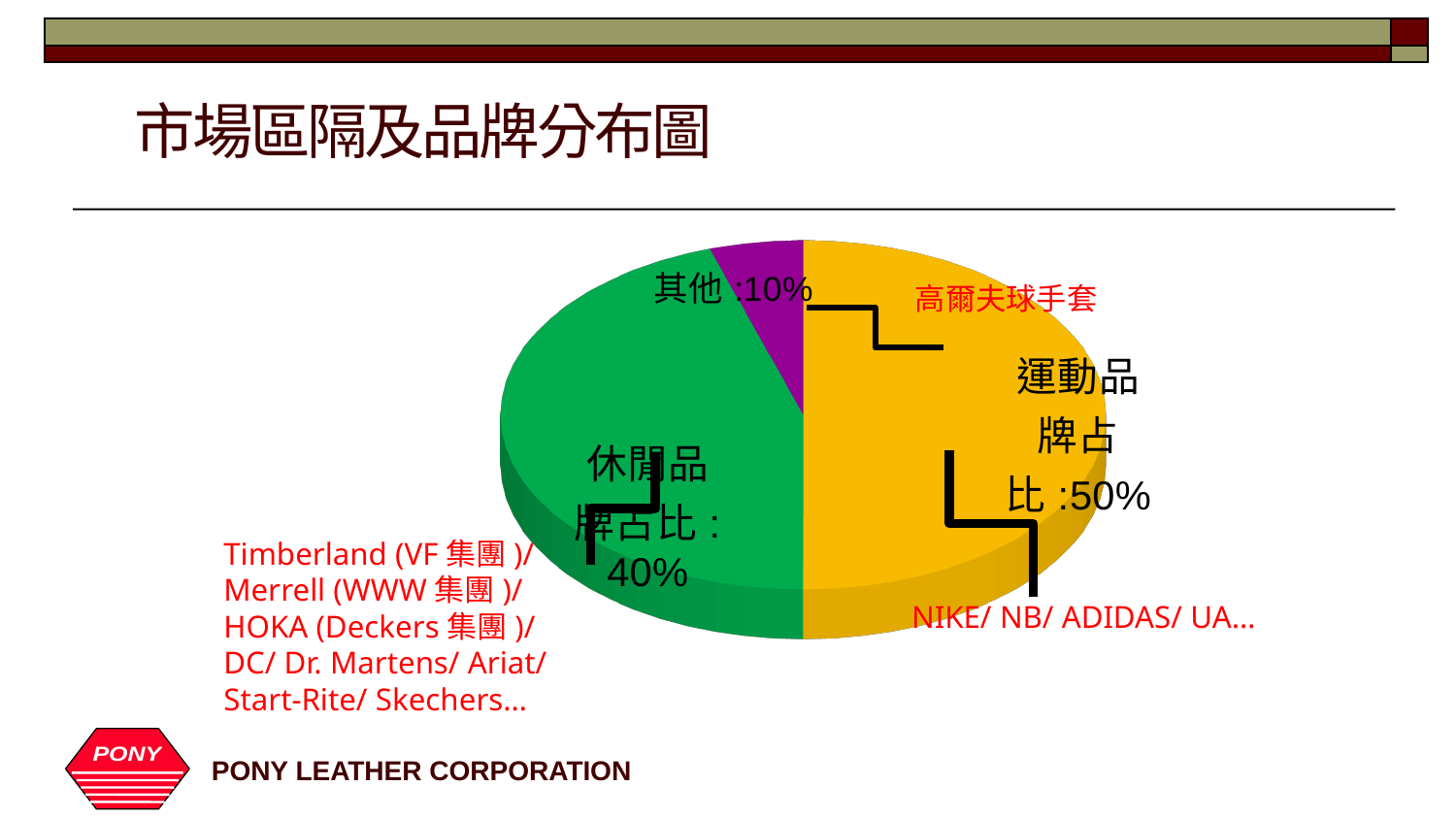
What is the share for 其他 in the pie chart? 10% How many slices does the pie chart have? 3 Which is larger, the 休閒品牌 slice or the 其他 slice? 休閒品牌 What is the title of the slide containing the pie chart? 市場區隔及品牌分布圖 What kind of chart is shown on the slide? pie chart What colour is the 其他 slice in the pie chart? purple What is the difference in percentage points between the 運動品牌 slice and the 休閒品牌 slice? 10% What is the combined share of the 運動品牌 and 休閒品牌 slices? 90% What is the share for 休閒品牌 in the pie chart? 40% Which category has the smallest slice in the pie chart? 其他 What is the share for 運動品牌 in the pie chart? 50% Which category has the largest slice in the pie chart? 運動品牌